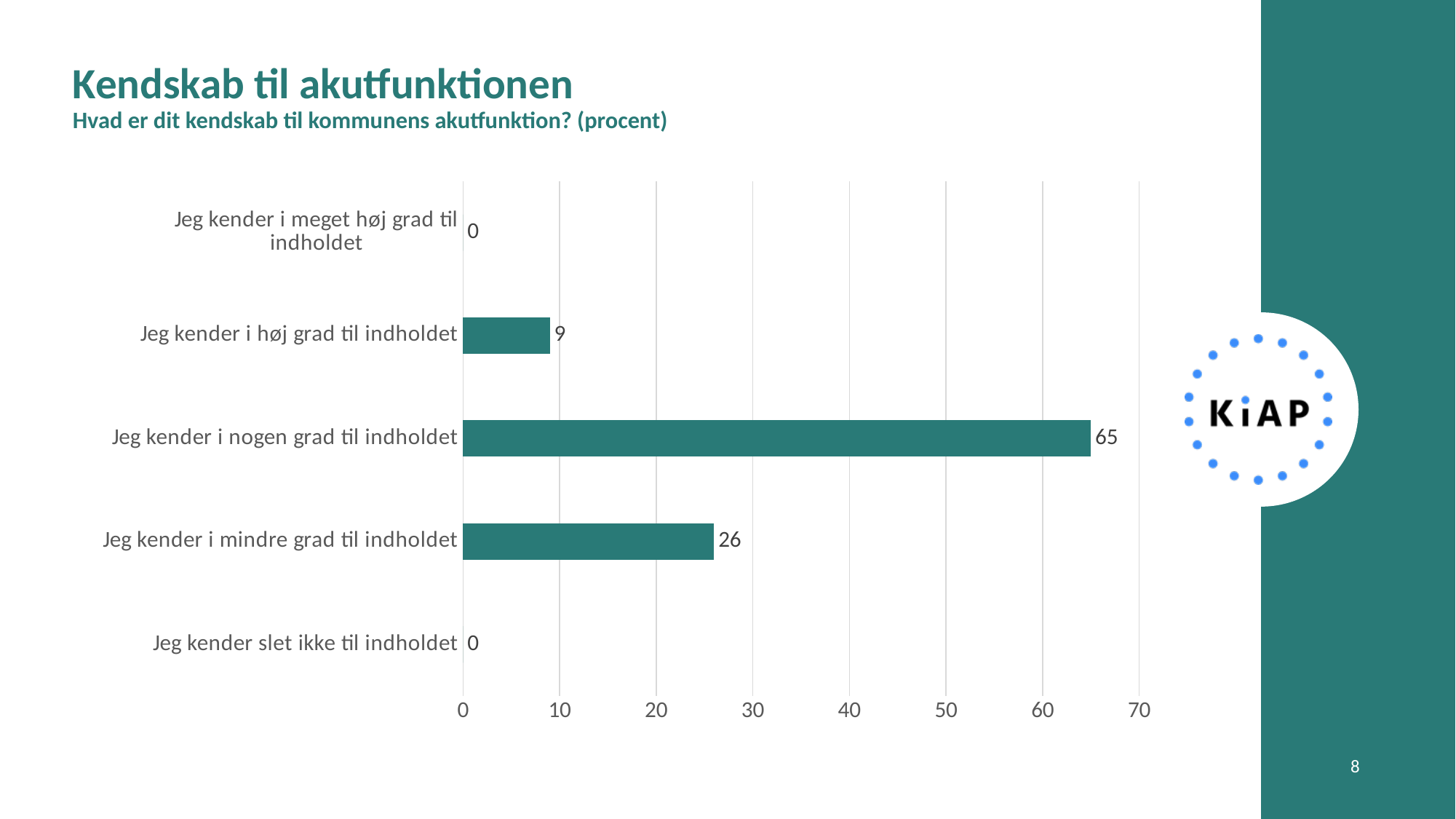
How many categories are shown on the chart? 5 What is the value for "Jeg kender i mindre grad til indholdet"? 26 Which category has the highest value? Jeg kender i nogen grad til indholdet What is the value for "Jeg kender i nogen grad til indholdet"? 65 What is the value for "Jeg kender slet ikke til indholdet"? 0 Is the value for "Jeg kender i nogen grad til indholdet" greater or less than 60? greater What is the value for "Jeg kender i høj grad til indholdet"? 9 Which is larger: the value for "Jeg kender i høj grad til indholdet" or "Jeg kender i mindre grad til indholdet"? Jeg kender i mindre grad til indholdet What is the title of the slide? Kendskab til akutfunktionen What is the difference between the values for "Jeg kender i nogen grad til indholdet" and "Jeg kender i mindre grad til indholdet"? 39 How many categories have a value of 0? 2 What kind of chart is shown on the slide? bar chart